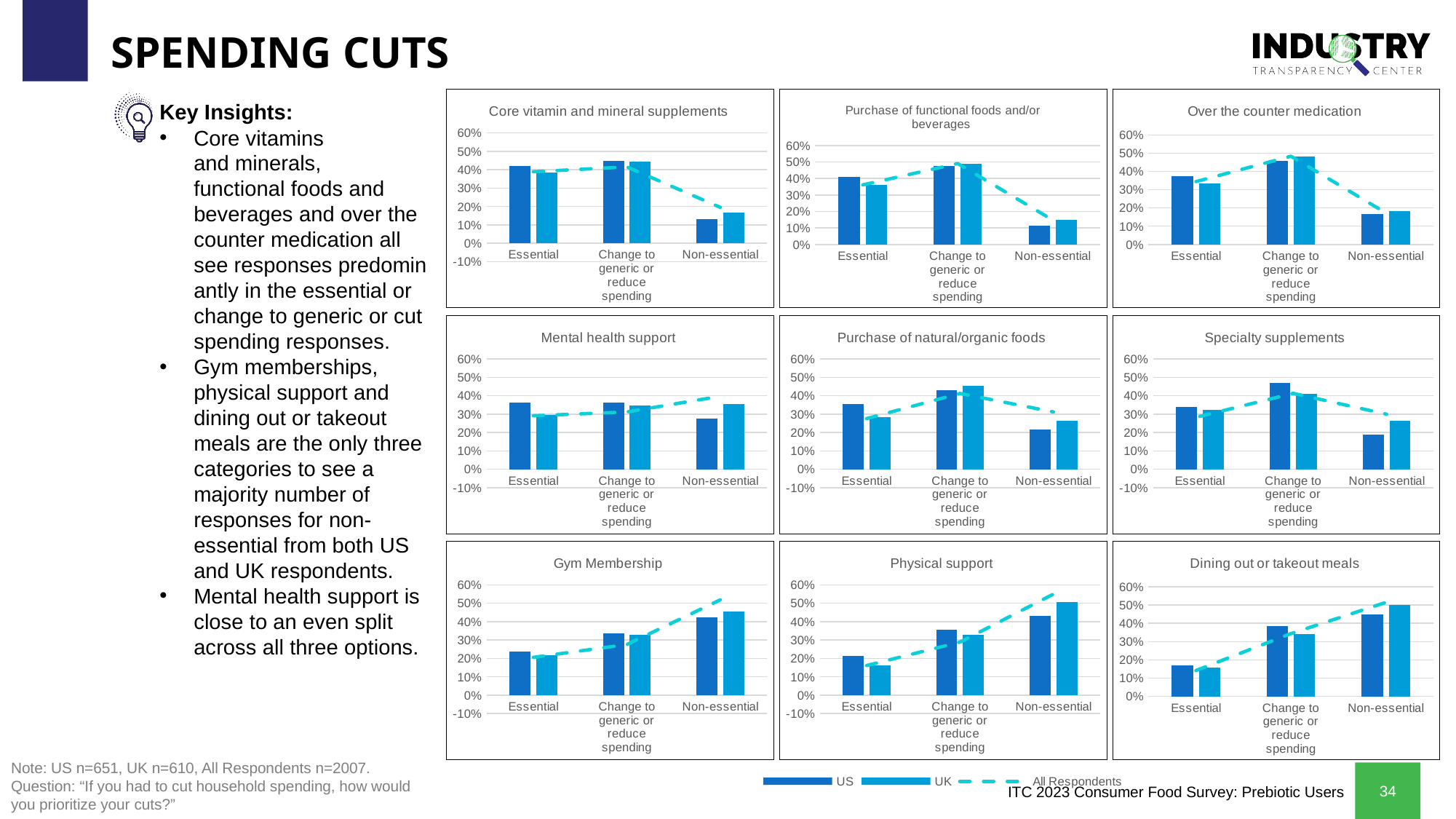
In the Mental health support chart, which is larger for Essential, the US value or the UK value? US In the Mental health support chart, which is larger for Non-essential, the US value or the UK value? UK In the Over the counter medication chart, which category has the highest US value? Change to generic or reduce spending How many categories are shown on the x axis of the Purchase of functional foods and/or beverages chart? 3 How many series does the shared legend at the bottom of the slide list? 3 In the Specialty supplements chart, which is larger for Change to generic or reduce spending, the US value or the UK value? US In the Physical support chart, is the UK value for Non-essential greater or less than 40%? greater In the Gym Membership chart, do the US values rise or fall from Essential to Non-essential? rise In the Core vitamin and mineral supplements chart, is the US value for Non-essential greater or less than 20%? less In the Dining out or takeout meals chart, is the US value for Essential greater or less than 20%? less In the Purchase of natural/organic foods chart, which category has the lowest US value? Non-essential In the Dining out or takeout meals chart, which category has the highest UK value? Non-essential